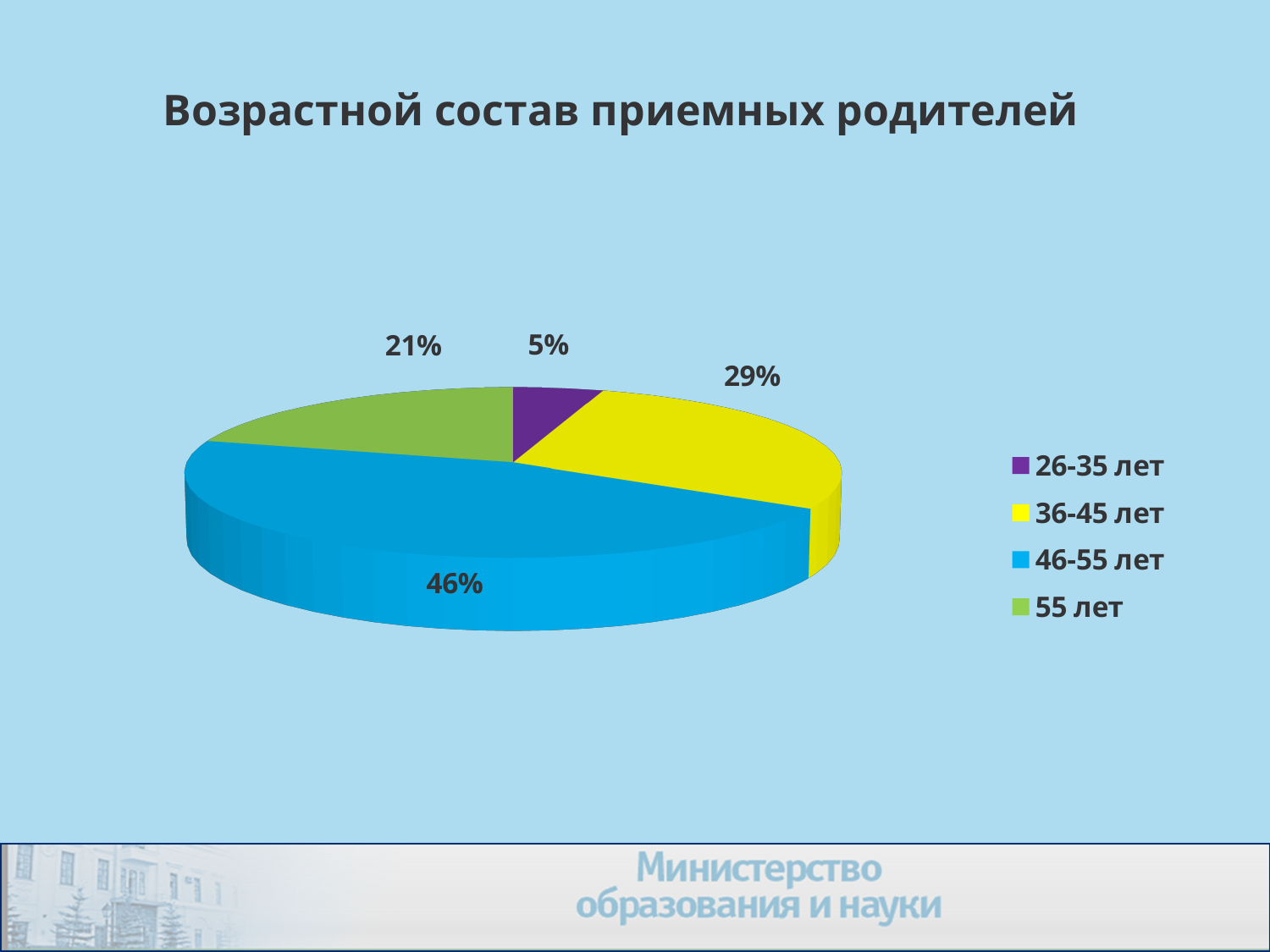
Which slice is larger: 36-45 лет or 55 лет? 36-45 лет What share of the pie is the 55 лет slice? 21% What share of the pie is the 46-55 лет slice? 46% What is the title of the chart? Возрастной состав приемных родителей How many slices does the pie chart have? 4 Which age group has the smallest share of the pie? 26-35 лет What kind of chart is shown on the slide? pie chart What share of the pie is the 26-35 лет slice? 5% What colour is the 46-55 лет slice? blue What is the difference in percentage points between the 46-55 лет slice and the 36-45 лет slice? 17% Which age group has the largest share of the pie? 46-55 лет